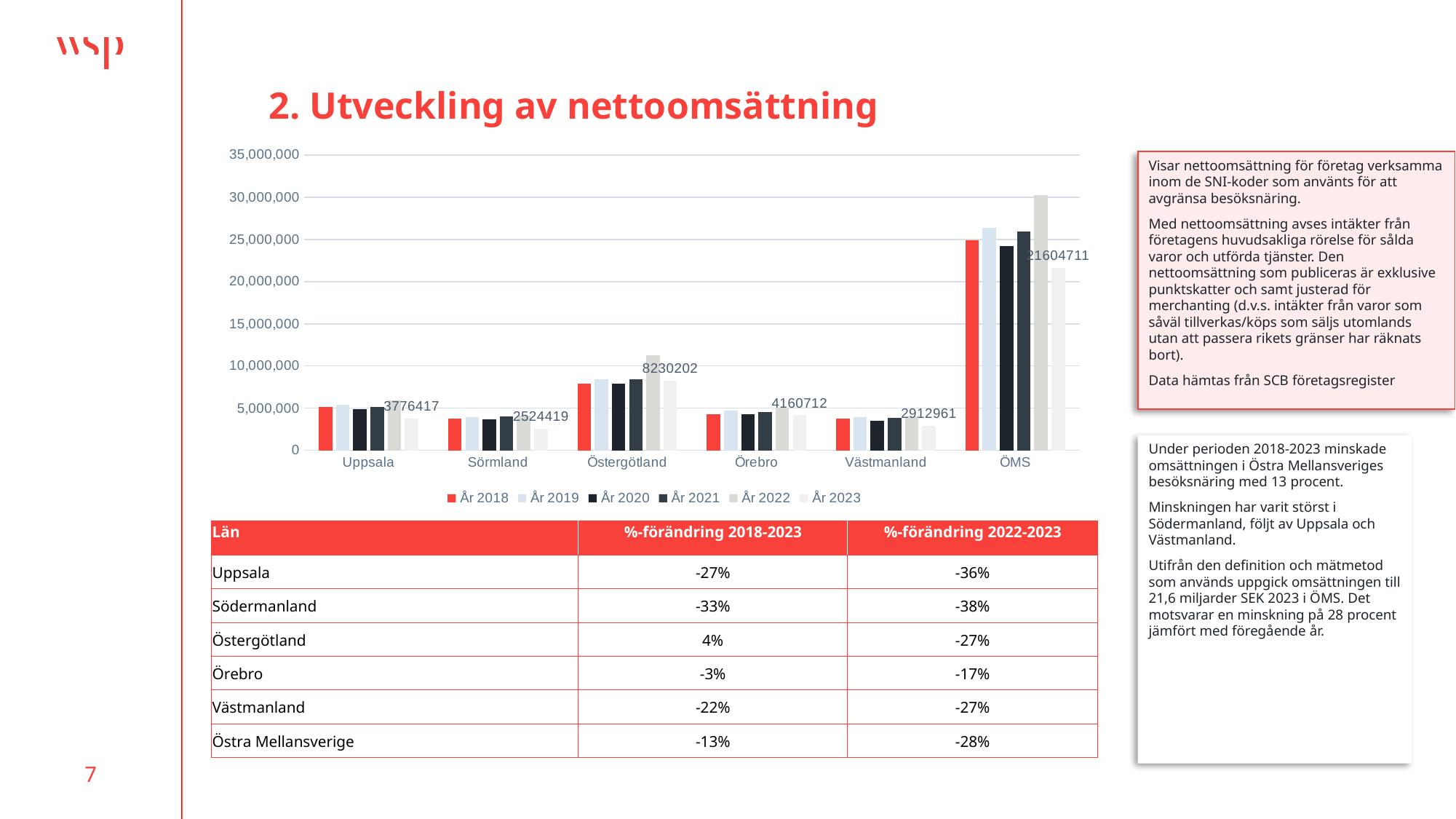
Which category has the lowest År 2023 value? Sörmland How many categories are shown on the x axis of the chart? 6 What is the År 2023 value for Östergötland? 8230202 Is the År 2022 value for Östergötland greater or less than 10,000,000? greater What is the År 2023 value for ÖMS? 21604711 What is the År 2023 value for Sörmland? 2524419 Which has the larger År 2023 value, Uppsala or Västmanland? Uppsala What is the difference between the År 2023 values for Östergötland and Örebro? 4069490 What kind of chart is shown on the slide? Bar chart What is the År 2023 value for Uppsala? 3776417 Which category has the highest År 2023 value? ÖMS How many series does the chart legend list? 6